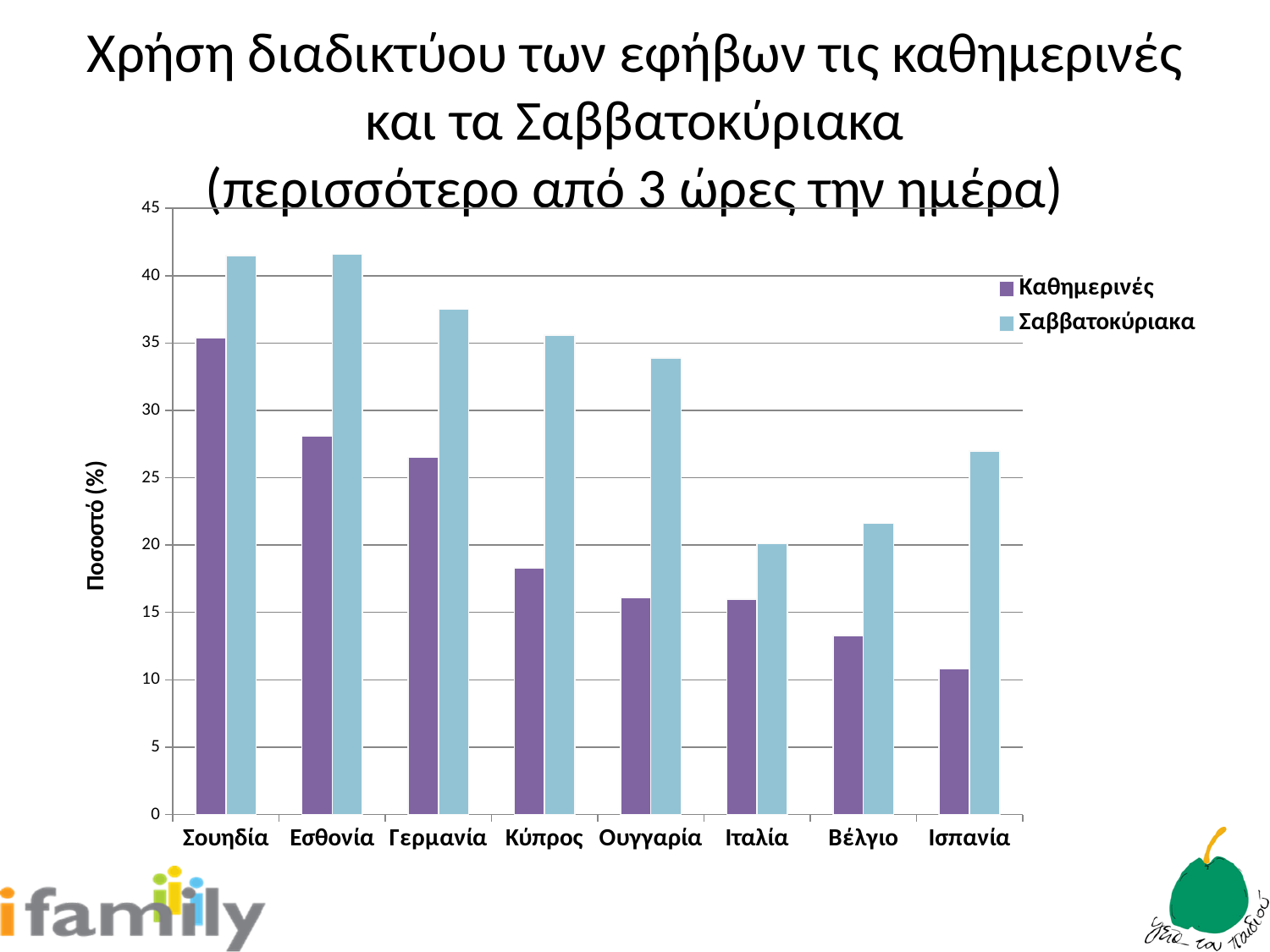
Do the Καθημερινές values rise or fall from Σουηδία to Ισπανία along the x axis? fall What kind of chart is shown on the slide? bar chart Is the Καθημερινές value for Ισπανία greater or less than 15? less How many series does the legend list? 2 Is the Καθημερινές value for Ιταλία greater or less than 20? less How many countries are shown on the x axis? 8 Which is larger: the Σαββατοκύριακα value for Ισπανία or for Βέλγιο? Ισπανία Is the Καθημερινές value for Σουηδία greater or less than 30? greater What is the title of the y axis? Ποσοστό (%) Which country has the lowest value for Καθημερινές? Ισπανία Which country has the highest value for Καθημερινές? Σουηδία